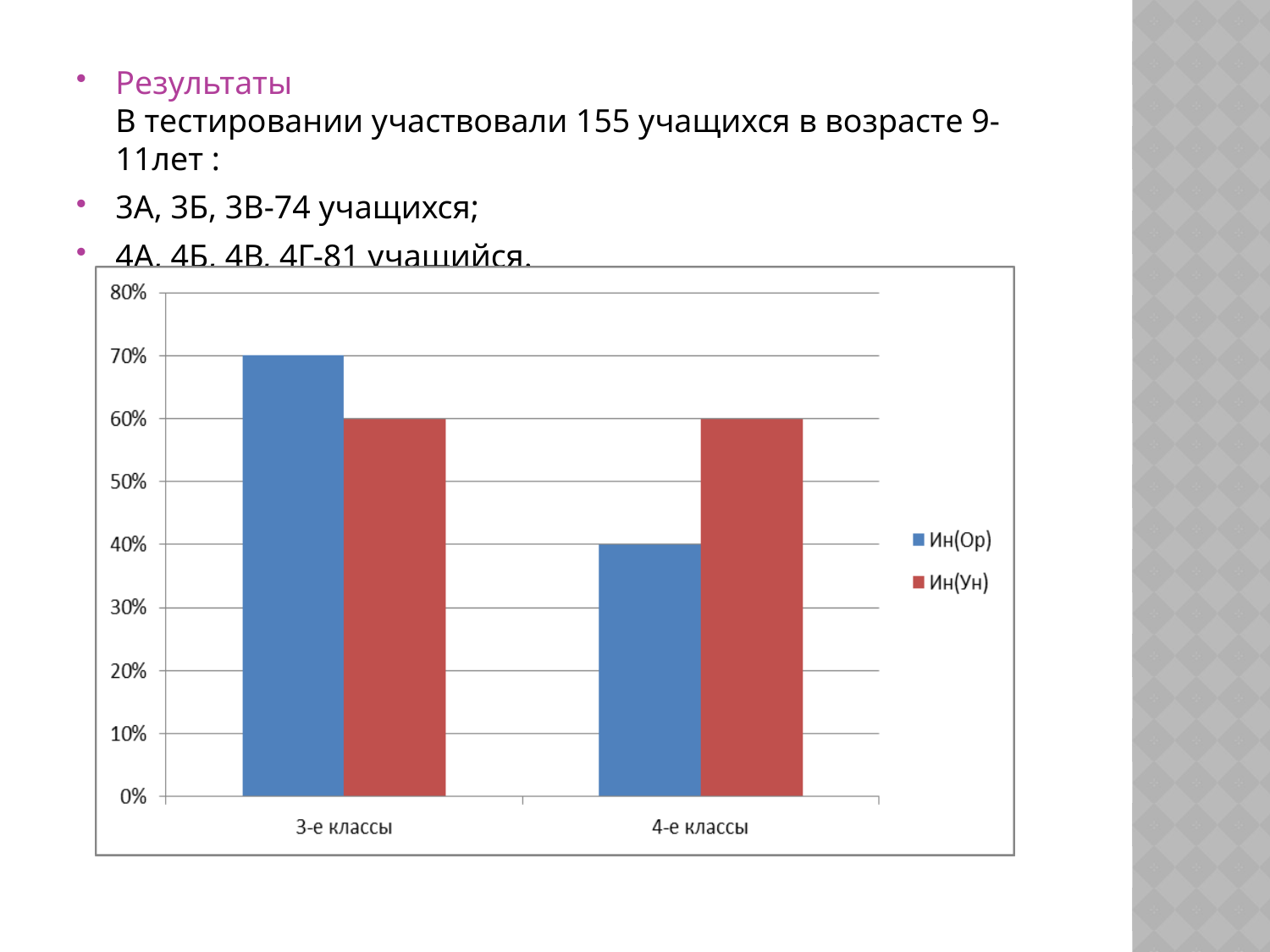
What is the value of Ин(Ун) for 4-е классы? 60% For 4-е классы, which is larger: Ин(Ор) or Ин(Ун)? Ин(Ун) What is the value of Ин(Ун) for 3-е классы? 60% Which category has the higher value for Ин(Ор)? 3-е классы Which category has the lowest value for Ин(Ор)? 4-е классы How many series does the legend list? 2 What is the value of Ин(Ор) for 3-е классы? 70% How many categories are shown on the x axis? 2 What kind of chart is shown on the slide? bar chart Which colour represents the Ин(Ун) series? red What is the difference between Ин(Ор) for 3-е классы and Ин(Ор) for 4-е классы? 30% What is the value of Ин(Ор) for 4-е классы? 40%